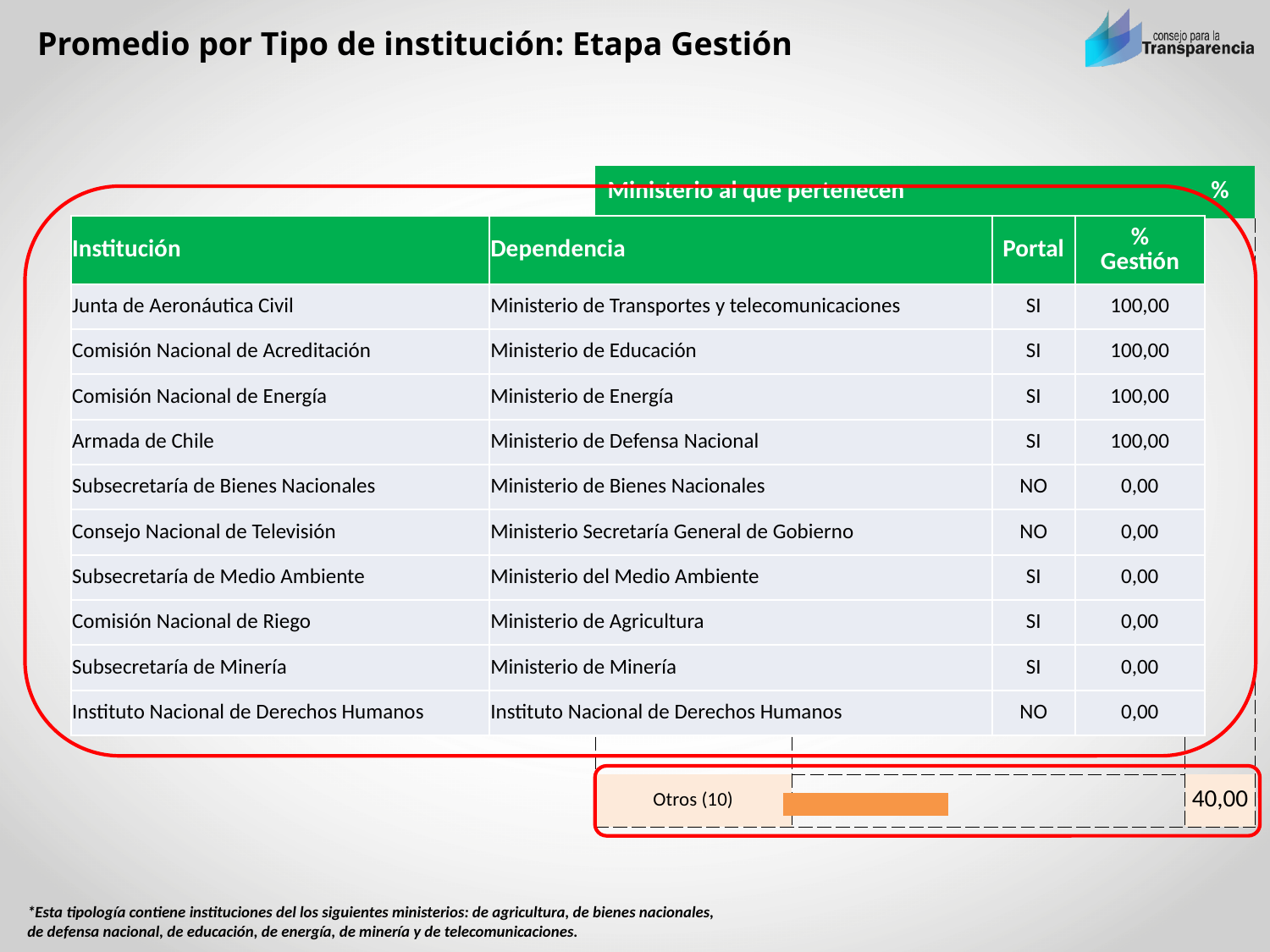
What is the value shown for the bar labelled "Otros (10)" in the chart at the bottom of the slide? 40,00 What is the label of the bar visible in the chart at the bottom of the slide? Otros (10) Is the value for "Otros (10)" in the bottom chart greater or less than 50? less What kind of chart is shown at the bottom of the slide? bar chart What colour is the bar for "Otros (10)" in the bottom chart? orange